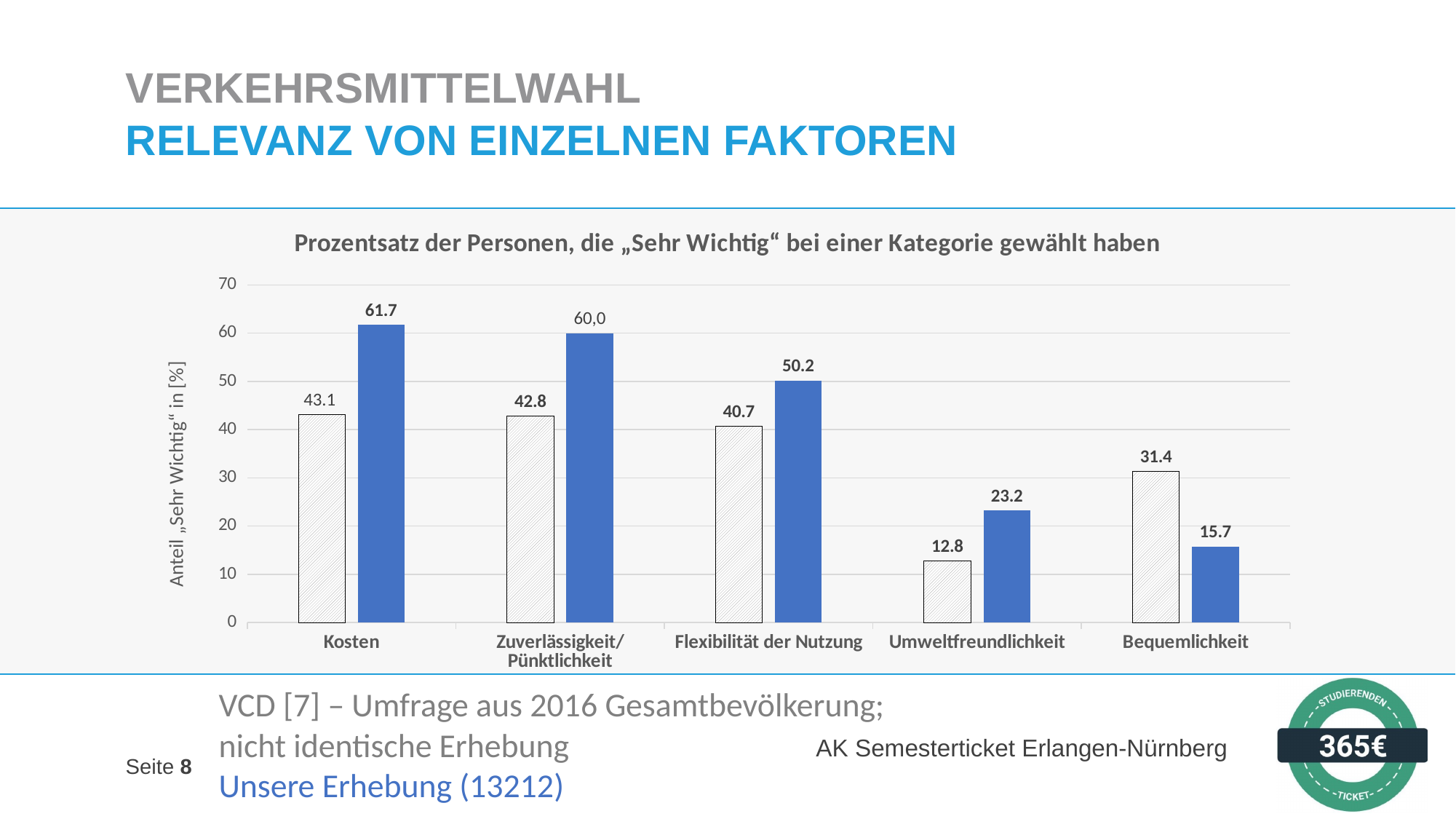
What is the difference between the blue bar and the hatched bar for Flexibilität der Nutzung? 9.5 For Bequemlichkeit, which bar is larger, the hatched bar or the blue bar? the hatched bar What is the value of the blue bar for Kosten? 61.7 Which category has the lowest hatched bar? Umweltfreundlichkeit What kind of chart is shown on the slide? bar chart What is the value of the hatched bar for Umweltfreundlichkeit? 12.8 What is the label of the y axis? Anteil „Sehr Wichtig“ in [%] Which category has the highest blue bar? Kosten Is the blue bar for Umweltfreundlichkeit greater or less than 20? greater How many categories are shown on the x axis? 5 What is the value of the hatched bar for Bequemlichkeit? 31.4 What is the value of the blue bar for Zuverlässigkeit/Pünktlichkeit? 60,0